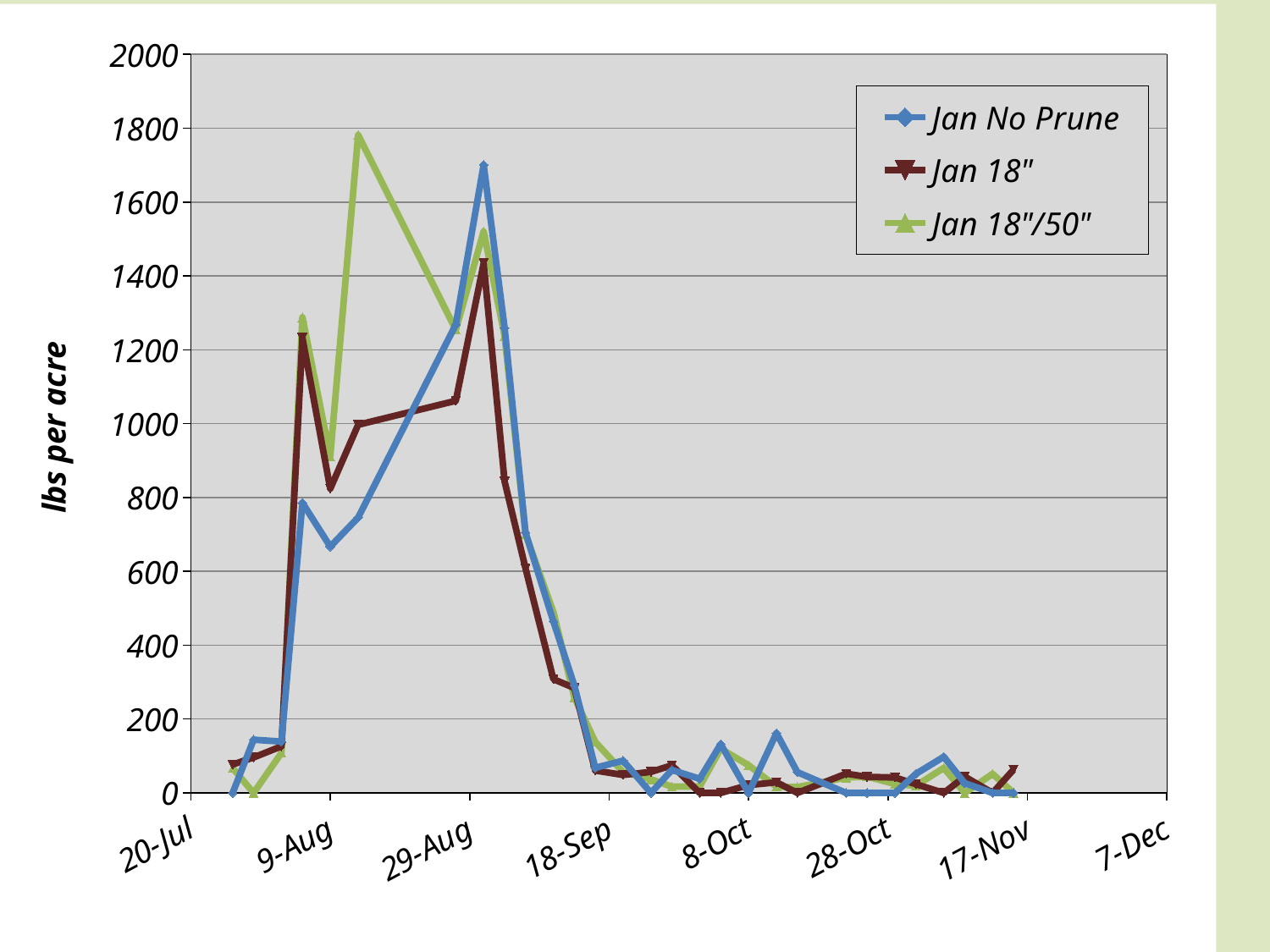
Are the values for all three series after 8-Oct greater or less than 200? less What is the label on the vertical axis? lbs per acre Do the values for all three series rise or fall between early September and 18-Sep? fall At the first spike shortly before 9-Aug, which is higher, Jan No Prune or Jan 18"? Jan 18" What kind of chart is shown on the slide? line chart Is the highest value reached by the Jan No Prune series greater or less than 1600? greater What are the three series named in the legend? Jan No Prune, Jan 18", Jan 18"/50" Is the highest value reached by the Jan 18"/50" series greater or less than 1600? greater Which series reaches the highest value on the chart? Jan 18"/50" How many series does the legend list? 3 What is the first date label shown on the horizontal axis? 20-Jul